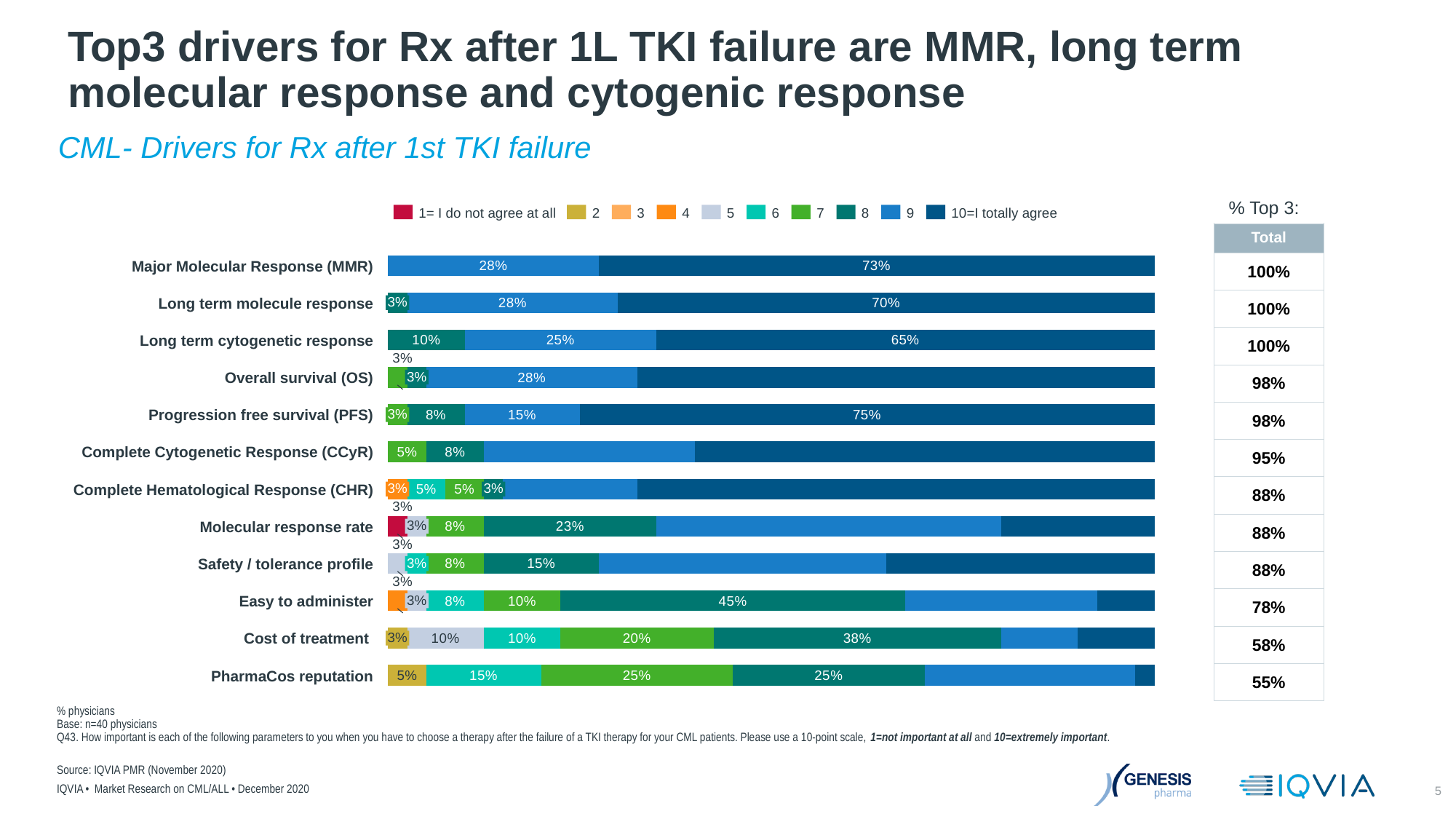
What label does the legend give to the rating of 1? 1= I do not agree at all What is the % Top 3 total for Cost of treatment? 58% Which driver has the lowest % Top 3 total? PharmaCos reputation How many rating levels does the legend list? 10 How many drivers (categories) are shown in the chart? 12 What percentage of physicians rated Progression free survival (PFS) as 10=I totally agree? 75% What percentage of physicians gave Easy to administer a rating of 8? 45% What percentage of physicians gave Cost of treatment a rating of 8? 38% Which has a larger 10=I totally agree share: Progression free survival (PFS) or Long term cytogenetic response? Progression free survival (PFS) What percentage of physicians rated Major Molecular Response (MMR) as 10=I totally agree? 73% What is the difference in the 10=I totally agree share between Major Molecular Response (MMR) and Long term molecule response? 3 percentage points What type of chart is used on this slide? Stacked bar chart